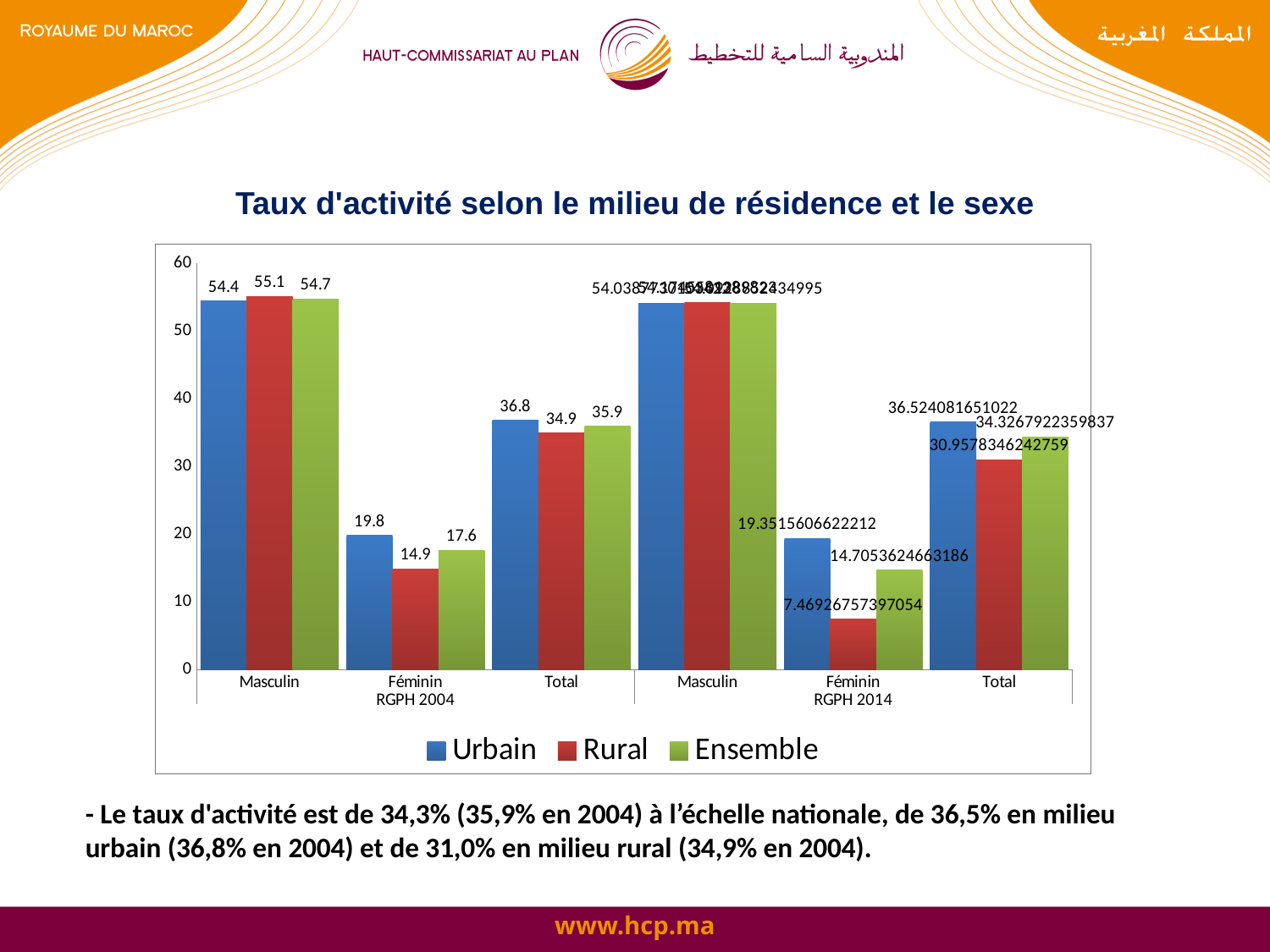
Is the Urbain value for Masculin in RGPH 2014 greater or less than 50? greater What is the title of the chart? Taux d'activité selon le milieu de résidence et le sexe What is the Rural value for Féminin in RGPH 2014? 7.46926757397054 Which series has the lowest value for Féminin in RGPH 2014? Rural What is the Urbain value for Masculin in RGPH 2004? 54.4 Which series has the highest value for Masculin in RGPH 2004? Rural What is the Rural value for Féminin in RGPH 2004? 14.9 What is the Ensemble value for Total in RGPH 2004? 35.9 How many series does the legend list? 3 Which is larger: the Urbain value for Féminin in RGPH 2004 or the Urbain value for Féminin in RGPH 2014? RGPH 2004 What kind of chart is shown on the slide? Bar chart What is the difference between the Urbain and Rural values for Total in RGPH 2004? 1.9